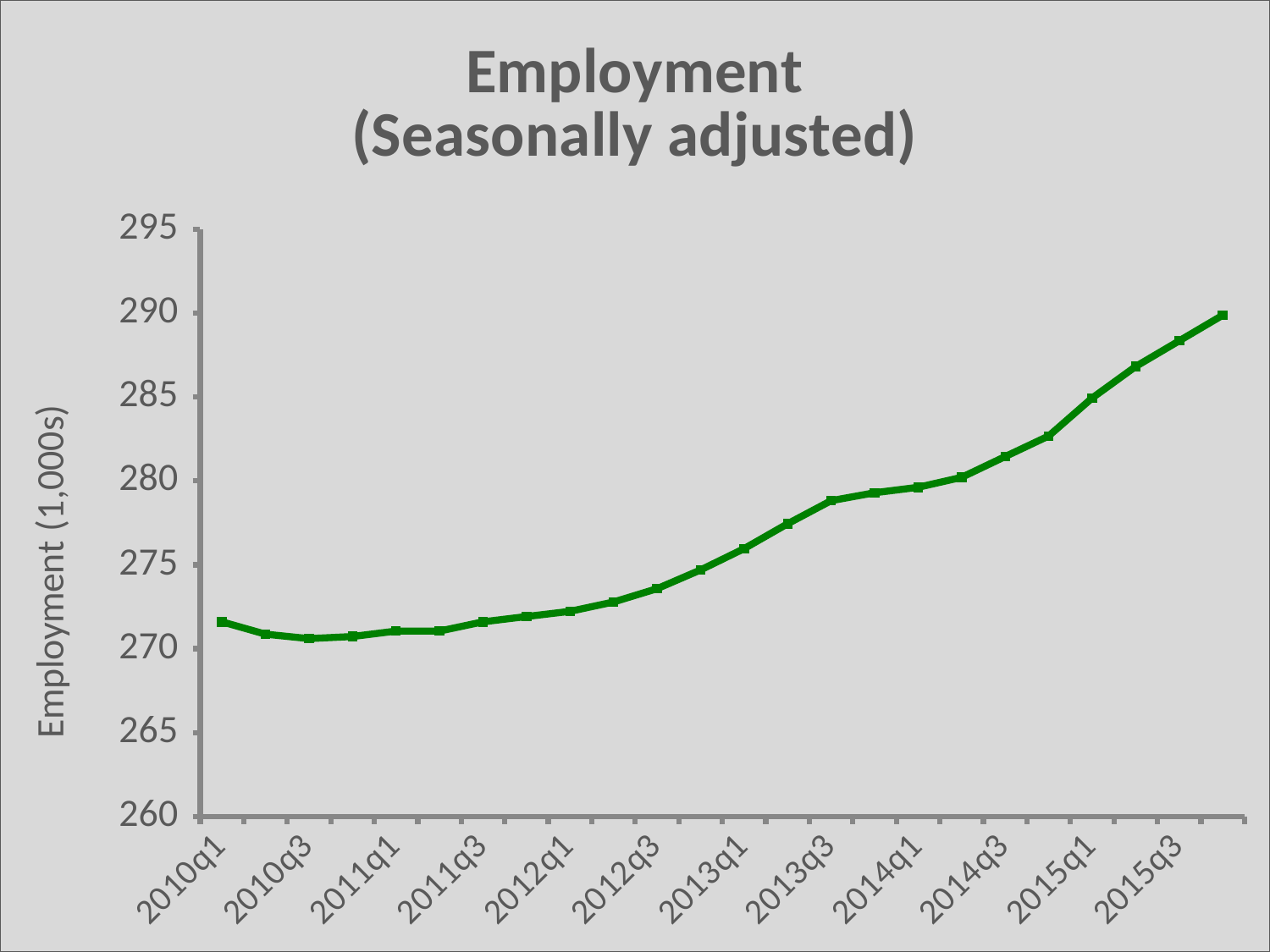
Is the value for 2015q3 greater or less than 285? greater Is the value for 2013q1 greater or less than 275? greater How many quarter labels are shown on the x axis? 12 Overall, does employment rise or fall from 2010q1 to the end of the series? rise Is the value for 2013q3 greater or less than 280? less What kind of chart is shown on the slide? line chart What is the label on the vertical axis? Employment (1,000s) What is the title of the chart? Employment (Seasonally adjusted) Which has the higher employment value, 2010q1 or 2015q1? 2015q1